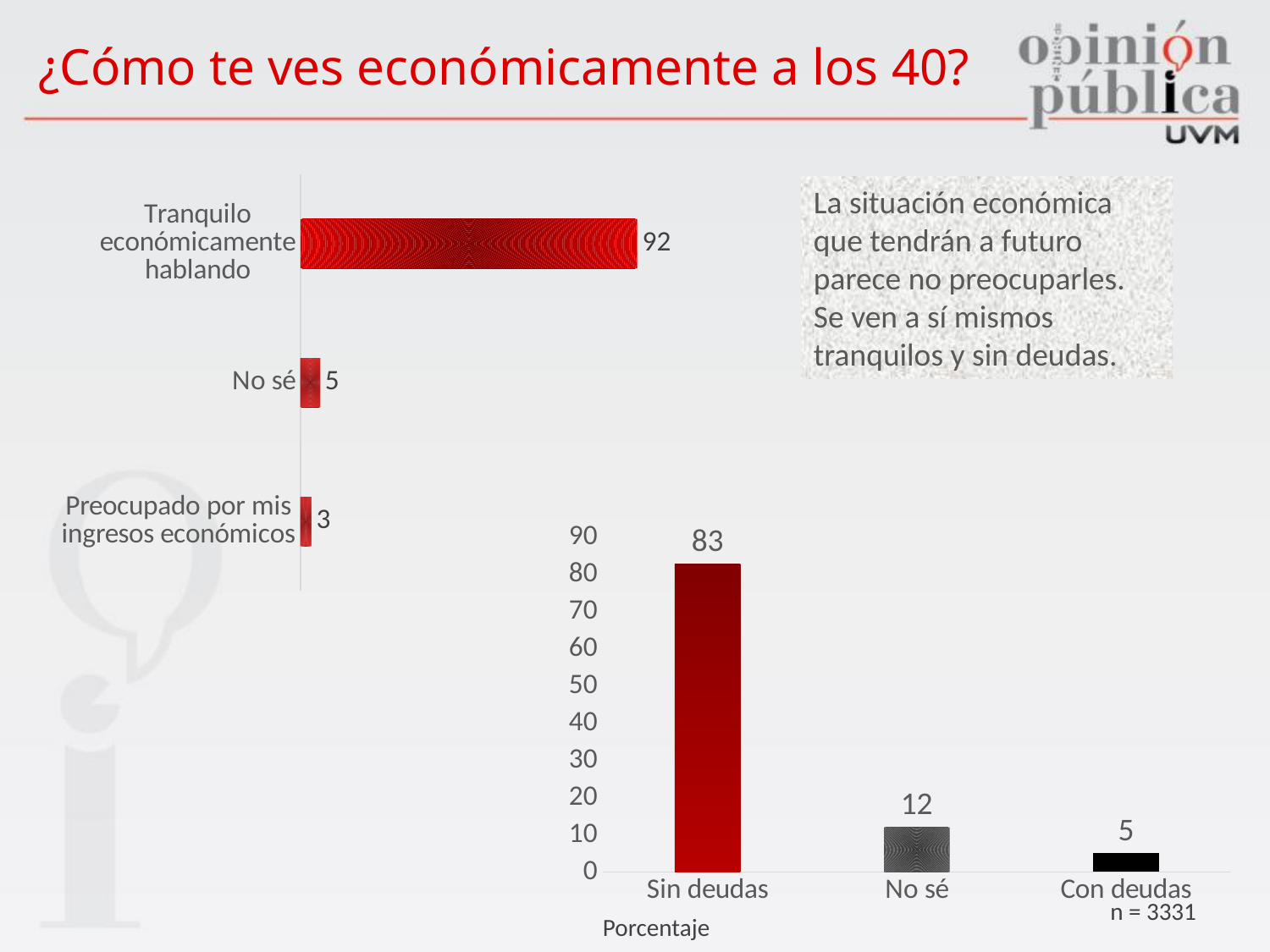
In the vertical bar chart at the bottom right, which is larger, "No sé" or "Con deudas"? No sé In the vertical bar chart at the bottom right, what is the value for "No sé"? 12 In the vertical bar chart at the bottom right, what is the value for "Sin deudas"? 83 What kind of chart is shown at the bottom right of the slide? Bar chart In the horizontal bar chart on the left, what is the value for "Tranquilo económicamente hablando"? 92 In the vertical bar chart at the bottom right, what is the difference between "Sin deudas" and "Con deudas"? 78 In the vertical bar chart at the bottom right, which category has the highest value? Sin deudas In the horizontal bar chart on the left, what is the value for "Preocupado por mis ingresos económicos"? 3 What is the sample size (n) shown on the slide? n = 3331 How many categories does the horizontal bar chart on the left show? 3 In the horizontal bar chart on the left, which category has the lowest value? Preocupado por mis ingresos económicos In the horizontal bar chart on the left, what is the difference between "Tranquilo económicamente hablando" and "No sé"? 87